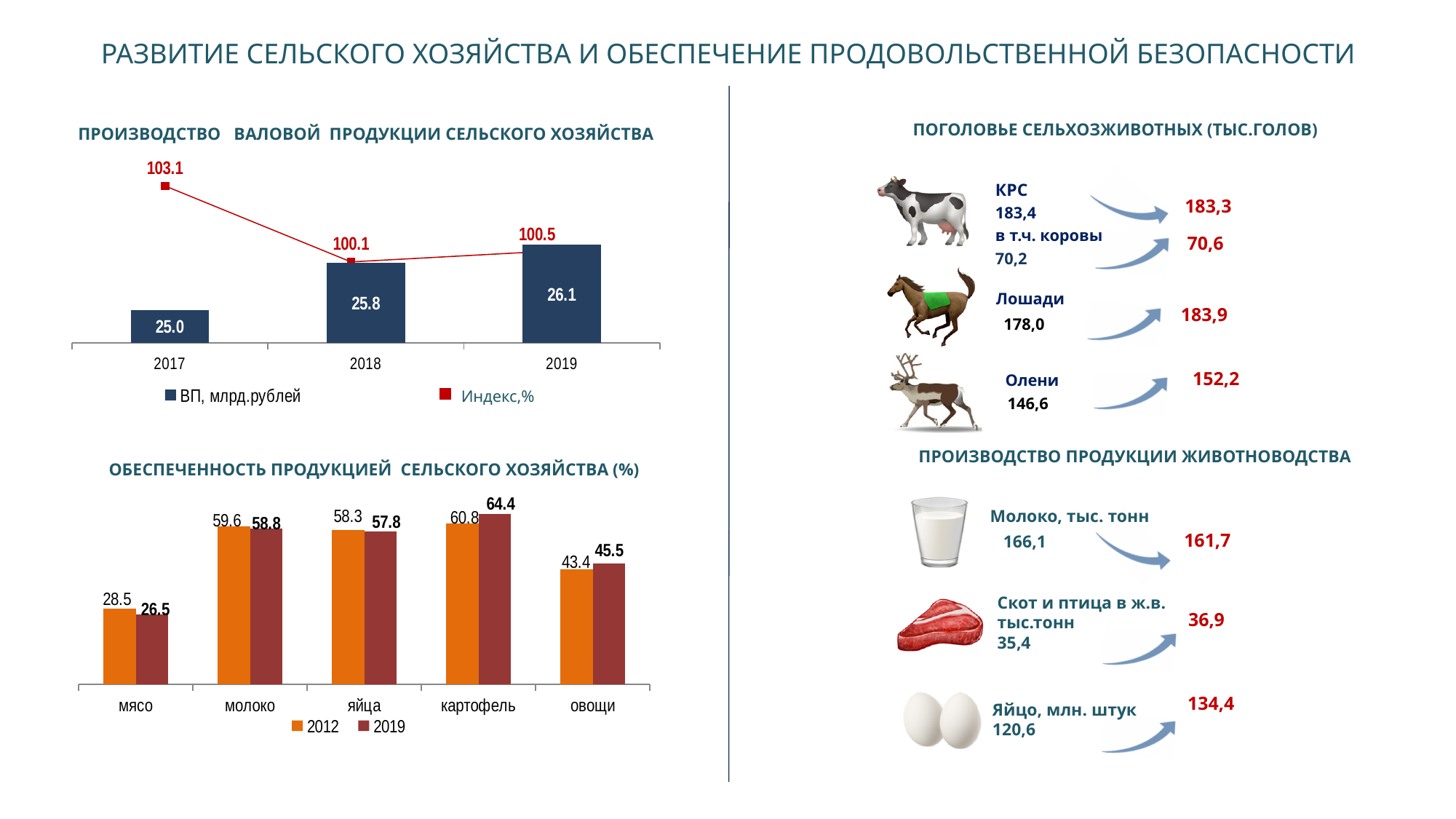
In the chart 'ОБЕСПЕЧЕННОСТЬ ПРОДУКЦИЕЙ СЕЛЬСКОГО ХОЗЯЙСТВА (%)', which category has the lowest 2019 value? мясо In the chart 'ПРОИЗВОДСТВО ВАЛОВОЙ ПРОДУКЦИИ СЕЛЬСКОГО ХОЗЯЙСТВА', do the values of 'ВП, млрд.рублей' rise or fall from 2017 to 2019? rise In the chart 'ОБЕСПЕЧЕННОСТЬ ПРОДУКЦИЕЙ СЕЛЬСКОГО ХОЗЯЙСТВА (%)', what is the 2019 value for 'картофель'? 64.4 In the chart 'ПРОИЗВОДСТВО ВАЛОВОЙ ПРОДУКЦИИ СЕЛЬСКОГО ХОЗЯЙСТВА', what is the value of 'Индекс,%' for 2017? 103.1 What kind of chart is 'ОБЕСПЕЧЕННОСТЬ ПРОДУКЦИЕЙ СЕЛЬСКОГО ХОЗЯЙСТВА (%)'? bar chart In the chart 'ПРОИЗВОДСТВО ВАЛОВОЙ ПРОДУКЦИИ СЕЛЬСКОГО ХОЗЯЙСТВА', what is the value of 'ВП, млрд.рублей' for 2018? 25.8 In the chart 'ПРОИЗВОДСТВО ВАЛОВОЙ ПРОДУКЦИИ СЕЛЬСКОГО ХОЗЯЙСТВА', which year has the highest value of 'ВП, млрд.рублей'? 2019 In the chart 'ОБЕСПЕЧЕННОСТЬ ПРОДУКЦИЕЙ СЕЛЬСКОГО ХОЗЯЙСТВА (%)', how many categories are shown on the x axis? 5 How many series does the legend of the chart 'ПРОИЗВОДСТВО ВАЛОВОЙ ПРОДУКЦИИ СЕЛЬСКОГО ХОЗЯЙСТВА' list? 2 In the chart 'ПРОИЗВОДСТВО ВАЛОВОЙ ПРОДУКЦИИ СЕЛЬСКОГО ХОЗЯЙСТВА', which year has the lowest value of 'Индекс,%'? 2018 In the chart 'ОБЕСПЕЧЕННОСТЬ ПРОДУКЦИЕЙ СЕЛЬСКОГО ХОЗЯЙСТВА (%)', what is the difference between the 2019 and 2012 values for 'картофель'? 3.6 In the chart 'ОБЕСПЕЧЕННОСТЬ ПРОДУКЦИЕЙ СЕЛЬСКОГО ХОЗЯЙСТВА (%)', what is the 2012 value for 'овощи'? 43.4